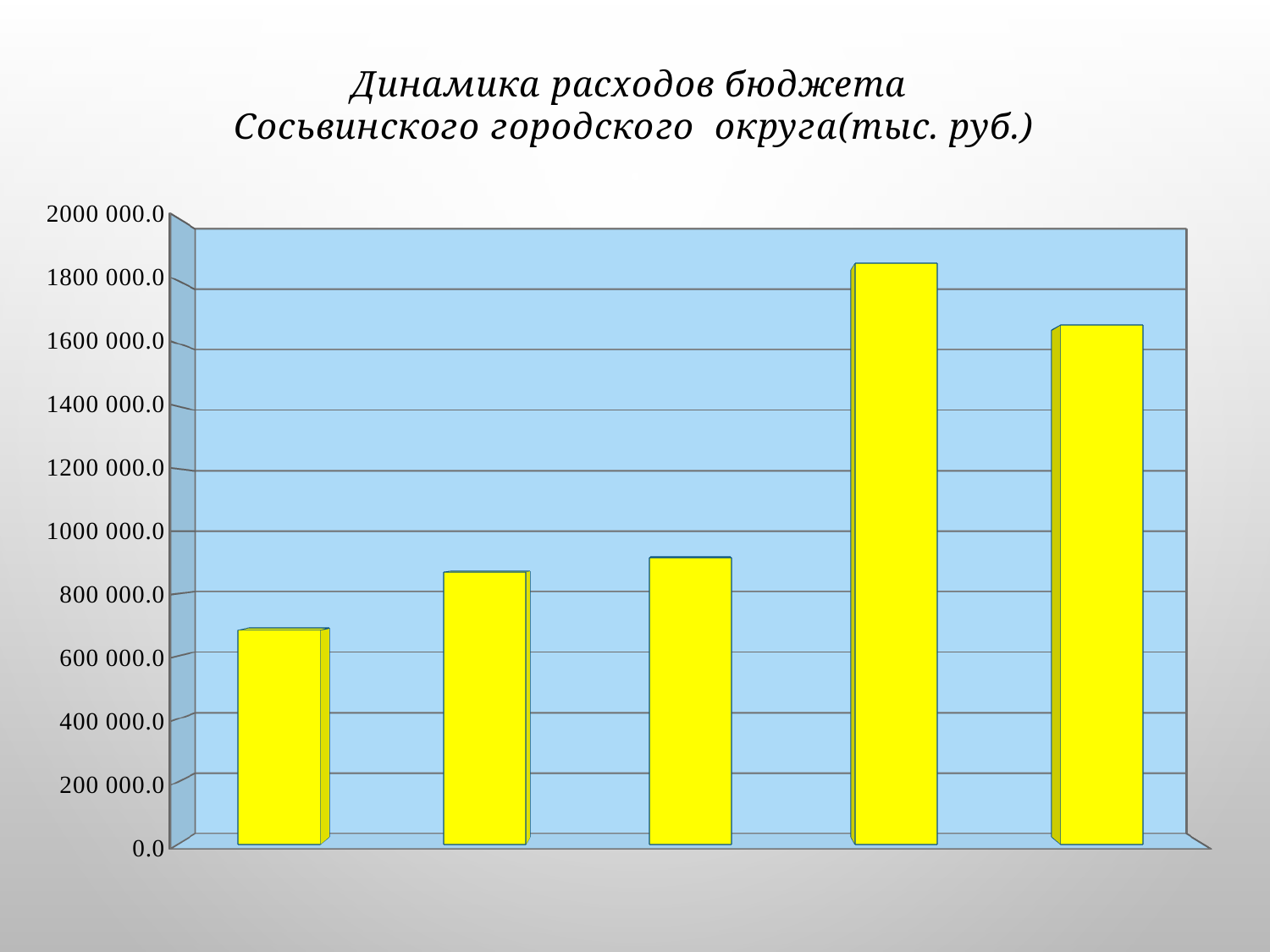
Which bar is the shortest in the chart? the first bar Which bar is the tallest in the chart? the fourth bar Is the value of the first bar greater or less than 800 000.0? less How many bars are plotted in the chart? 5 Is the value of the third bar greater or less than 1000 000.0? less What kind of chart is shown on the slide? bar chart Which is larger, the second bar or the third bar? the third bar Is the value of the fifth bar greater or less than 1600 000.0? greater From the first bar to the third bar, do the values rise or fall? rise What unit is given in the chart title? тыс. руб. Which is larger, the fourth bar or the fifth bar? the fourth bar